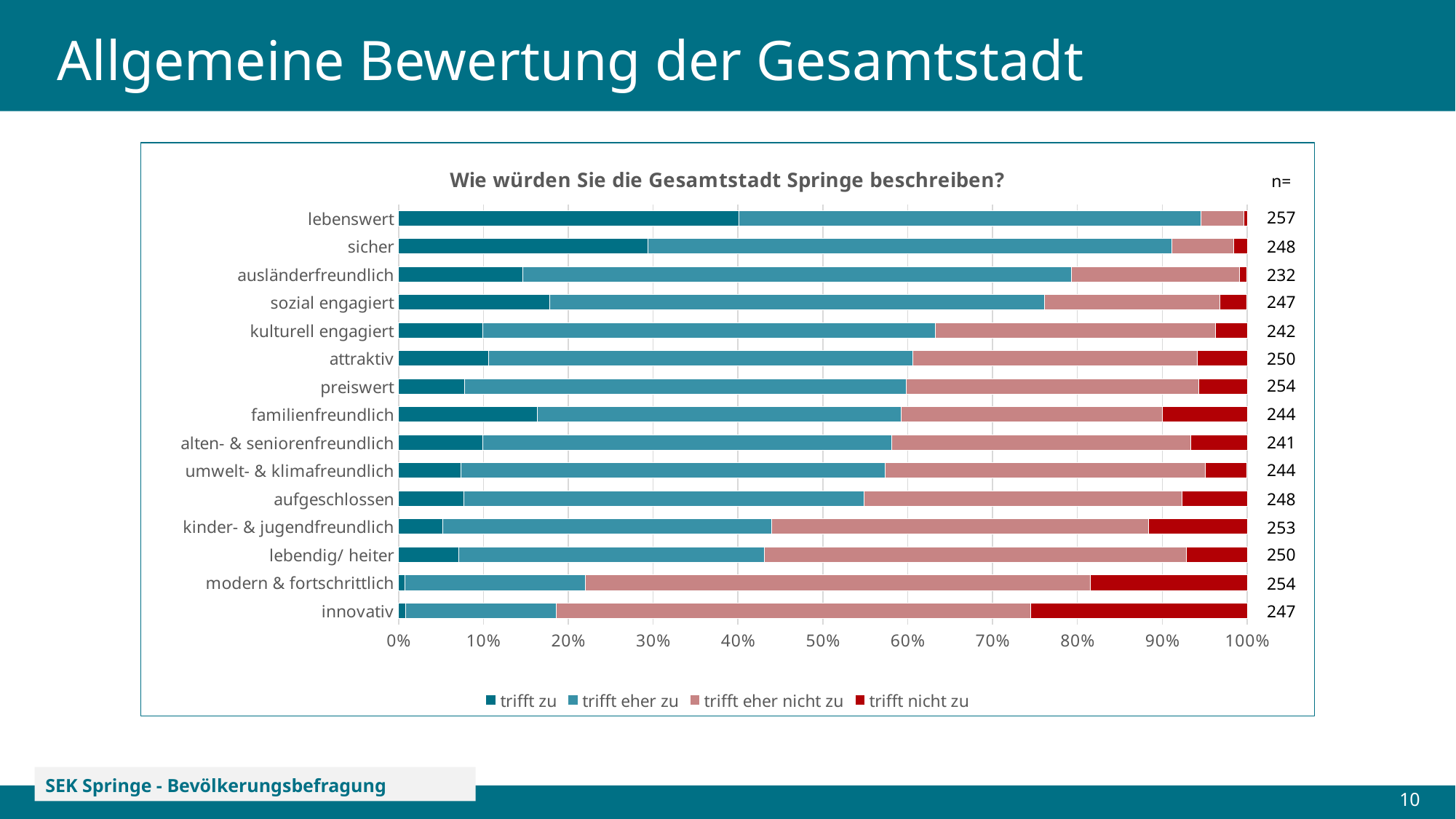
Is the 'trifft zu' share for 'lebenswert' greater or less than 30%? greater Which category has the highest n= value? lebenswert Which category has the largest 'trifft zu' share? lebenswert How many categories (attributes) are listed on the chart? 15 What is the n= value for 'ausländerfreundlich'? 232 Which category has the largest 'trifft nicht zu' share? innovativ What is the n= value for 'lebenswert'? 257 What is the difference between the n= values for 'lebenswert' and 'ausländerfreundlich'? 25 What is the title of the chart? Wie würden Sie die Gesamtstadt Springe beschreiben? How many series does the legend list? 4 What kind of chart is shown on the slide? stacked bar chart Which category has the lowest n= value? ausländerfreundlich